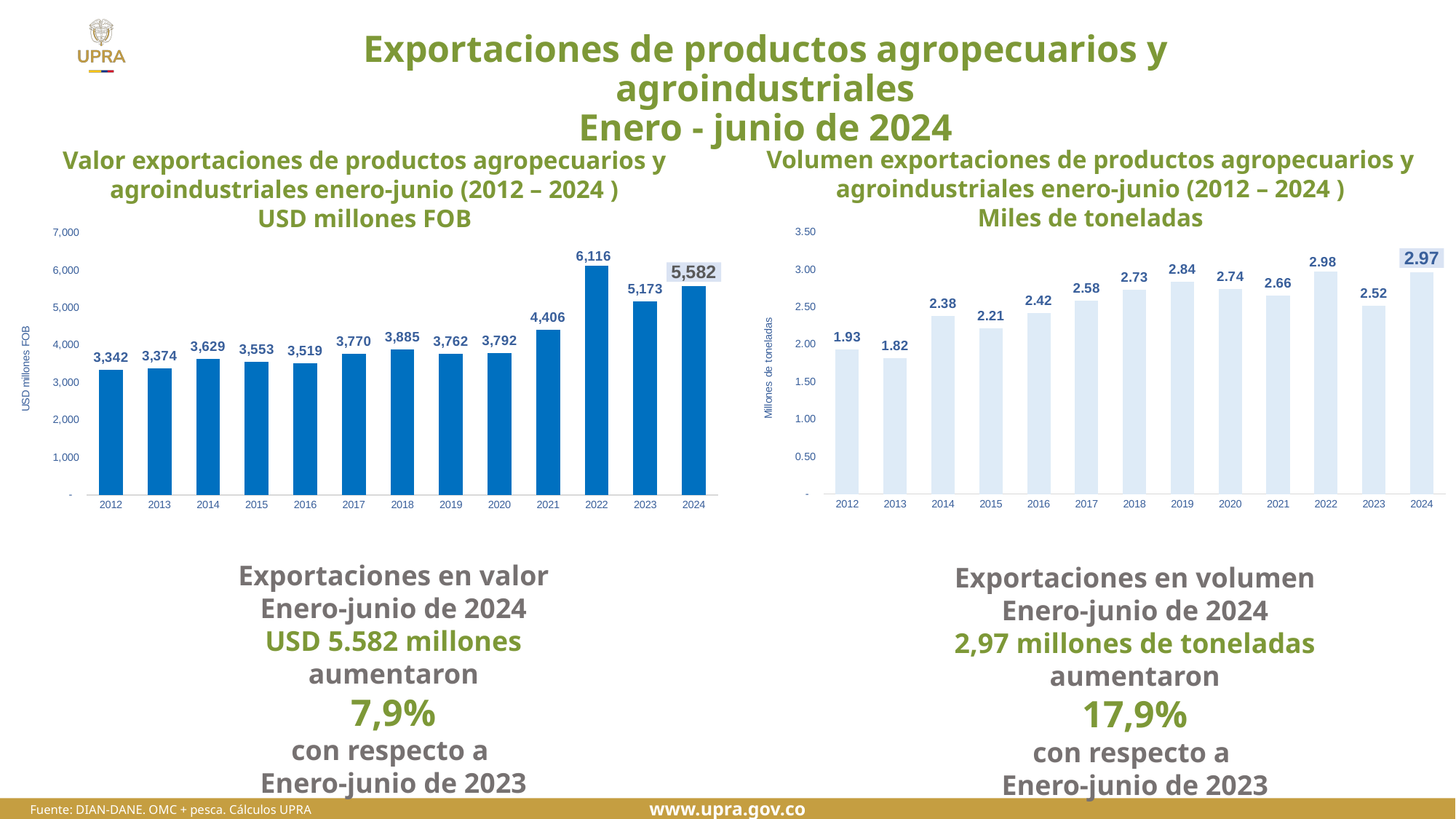
In the left chart (Valor exportaciones), which year has the highest value? 2022 In the left chart (Valor exportaciones), what is the difference between the 2022 and 2023 values? 943 In the left chart (Valor exportaciones), is the value for 2021 greater or less than 4,000? greater What is the y-axis label of the left chart (Valor exportaciones)? USD millones FOB In the right chart (Volumen exportaciones), what is the value for 2019? 2.84 In the left chart (Valor exportaciones), which year has the lowest value? 2012 In the left chart (Valor exportaciones), how many years are plotted? 13 What kind of chart is the right chart (Volumen exportaciones)? Bar chart In the left chart (Valor exportaciones), what is the value for 2024? 5,582 In the right chart (Volumen exportaciones), which is larger, the value for 2021 or the value for 2023? 2021 In the right chart (Volumen exportaciones), what is the difference between the 2024 and 2023 values? 0.45 In the right chart (Volumen exportaciones), which year has the lowest value? 2013